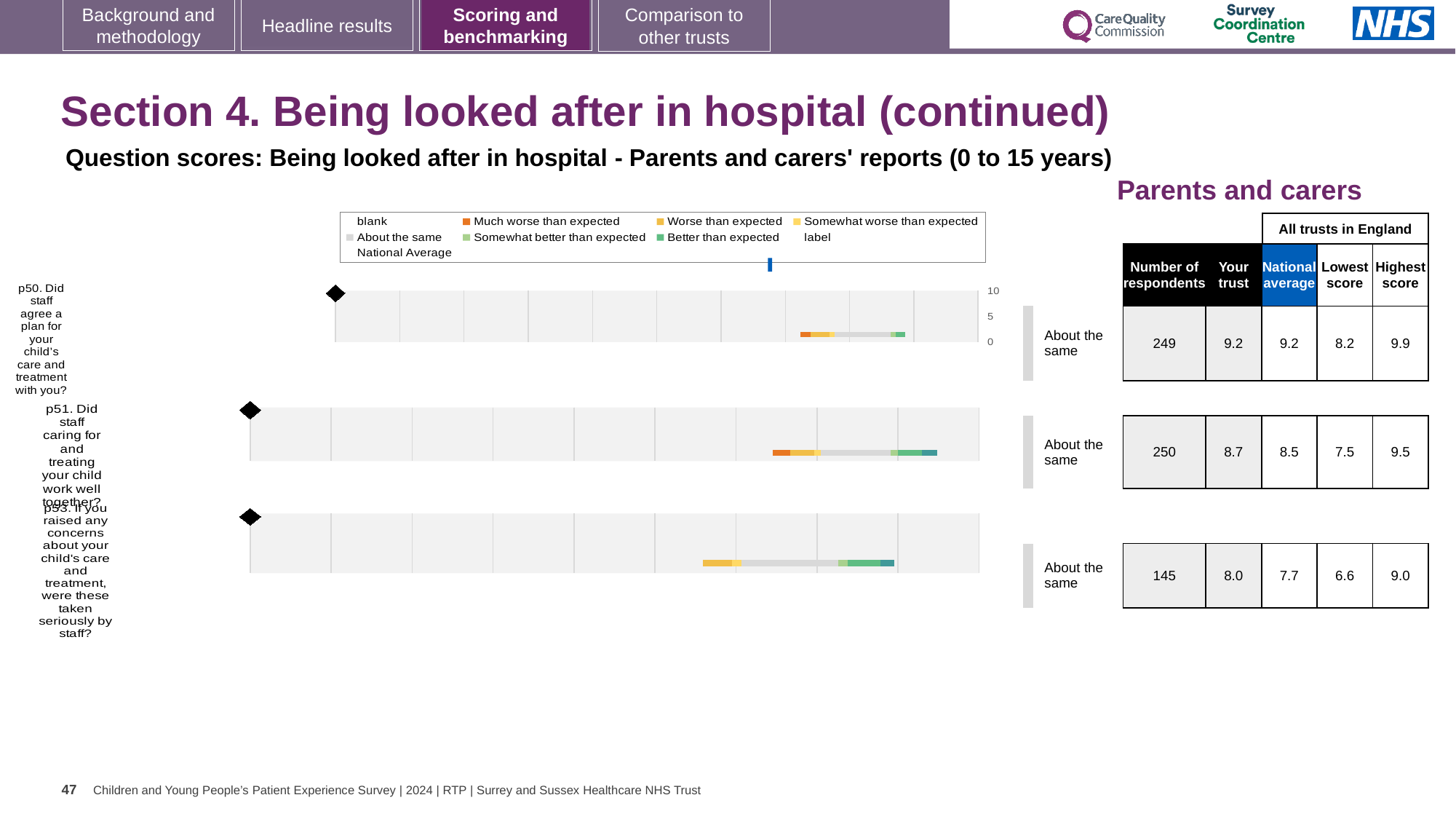
Which question has the lowest number of respondents? p53 How many survey questions are plotted on the slide? 3 What is the 'Your trust' score for p50 (Did staff agree a plan for your child's care and treatment with you?)? 9.2 Which colour in the legend represents 'Much worse than expected'? orange What is the highest score among all trusts in England for p51? 9.5 What kind of chart is used to show the question scores on this slide? bar chart How many respondents are listed for p53 (If you raised any concerns about your child's care and treatment, were these taken seriously by staff?)? 145 What is the difference between the 'Your trust' score and the national average for p51? 0.2 Which question has the highest 'Your trust' score? p50 What is the national average score for p51 (Did staff caring for and treating your child work well together?)? 8.5 What is the highest value shown on the score axis of the p50 chart? 10 For p53, which is larger: the 'Your trust' score or the national average? Your trust